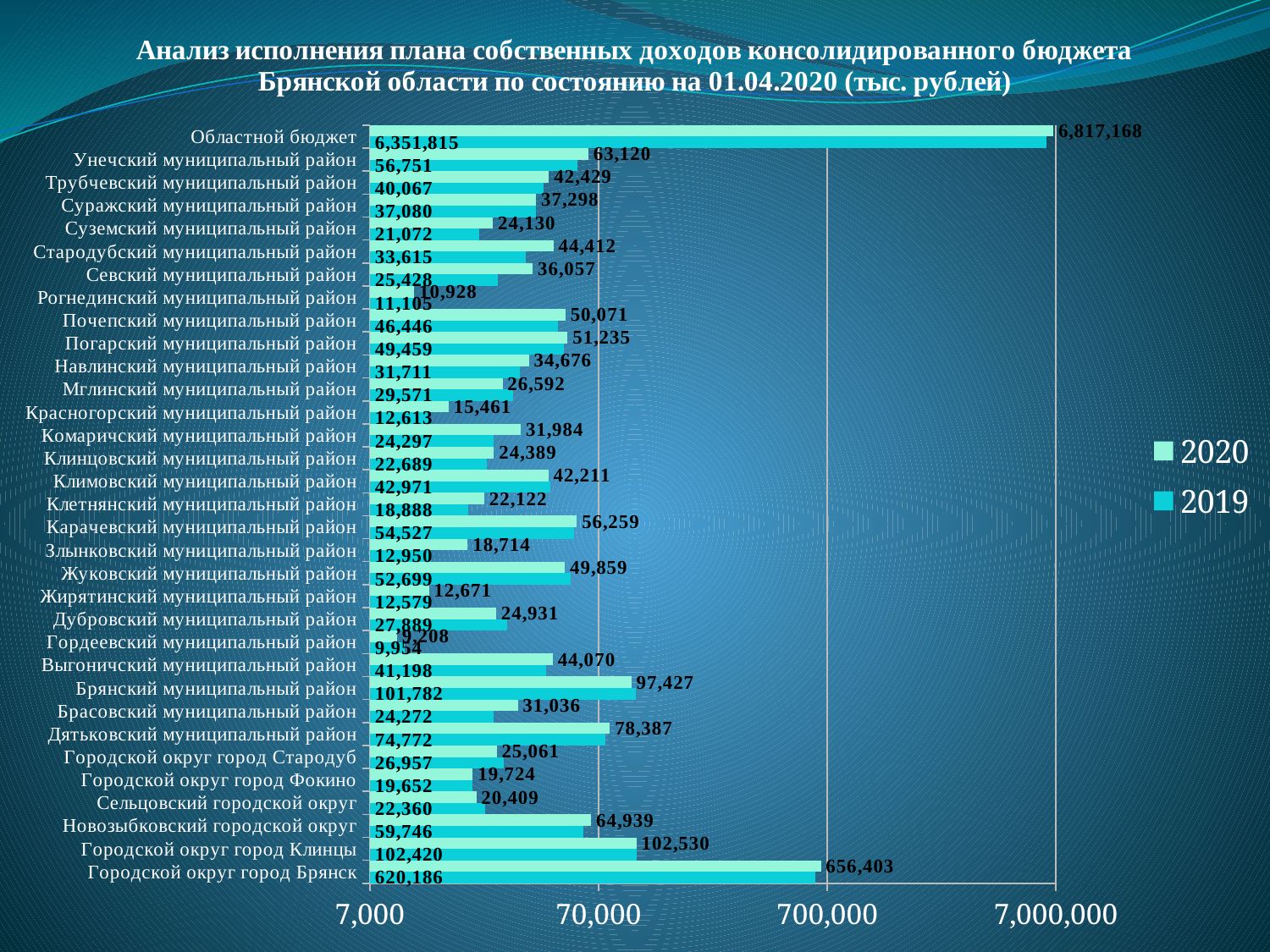
What is the 2019 value for Брянский муниципальный район? 101,782 Which category has the lowest 2020 value? Гордеевский муниципальный район What is the 2019 value for Городской округ город Брянск? 620,186 How many categories are shown on the chart? 33 Which category has the highest 2020 value? Областной бюджет Which is larger for Жуковский муниципальный район, the 2020 value or the 2019 value? 2019 How many series does the legend list? 2 What kind of chart is shown on the slide? bar chart What is the 2020 value for Унечский муниципальный район? 63,120 Is the 2020 value for Городской округ город Клинцы greater or less than 70,000? greater What is the 2020 value for Областной бюджет? 6,817,168 What is the difference between the 2020 and 2019 values for Областной бюджет? 465,353